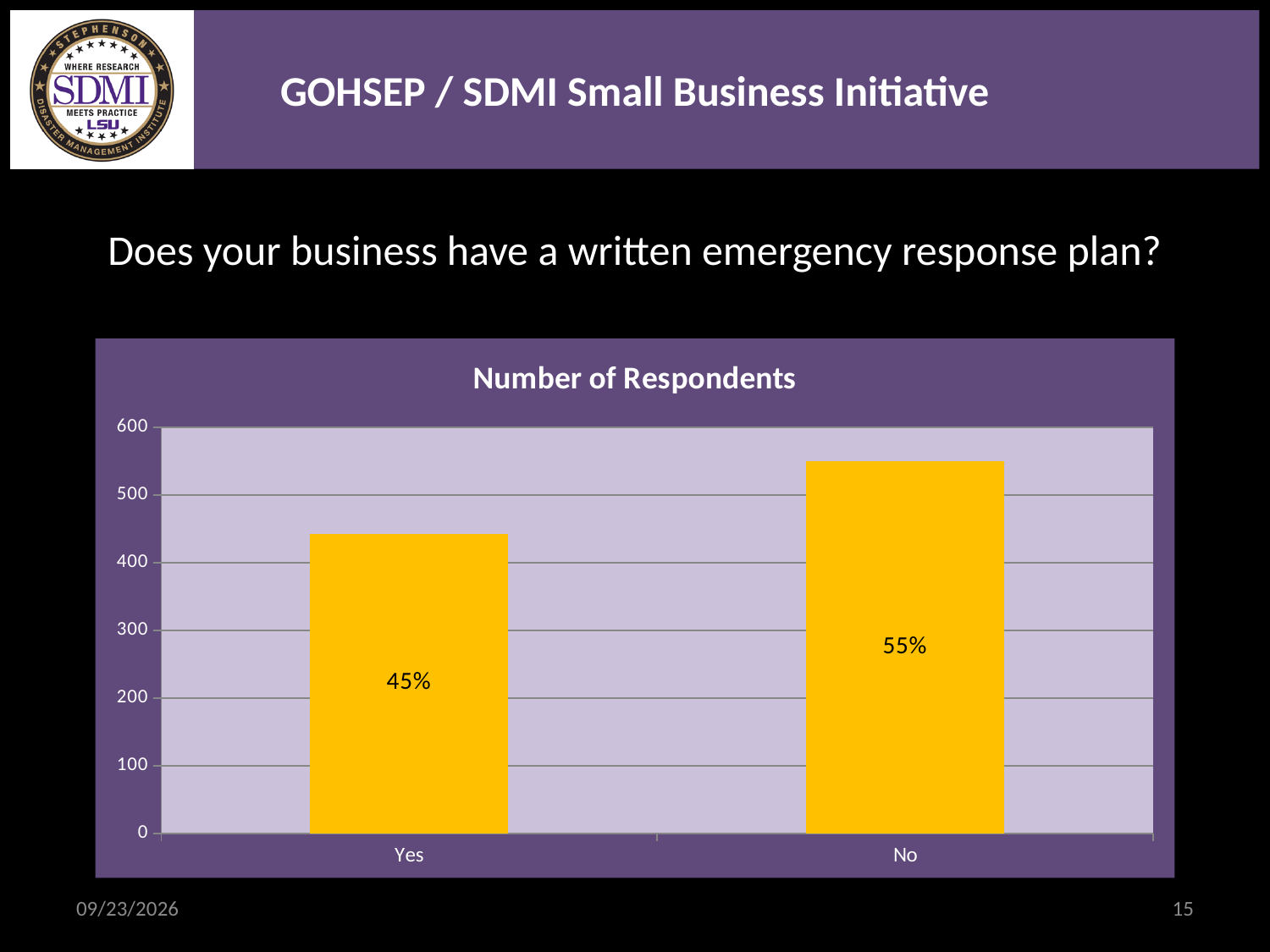
Is the bar for No taller than the bar for Yes? Yes How many categories are shown on the x axis? 2 Which category has the lower number of respondents? Yes Is the number of respondents for No greater or less than 600? less Which category has the higher number of respondents? No Is the number of respondents for No greater or less than 500? greater What percentage label is shown on the No bar? 55% Is the number of respondents for Yes greater or less than 400? greater What type of chart is shown on the slide? Bar chart What percentage label is shown on the Yes bar? 45% By how many percentage points does the No label exceed the Yes label? 10 percentage points